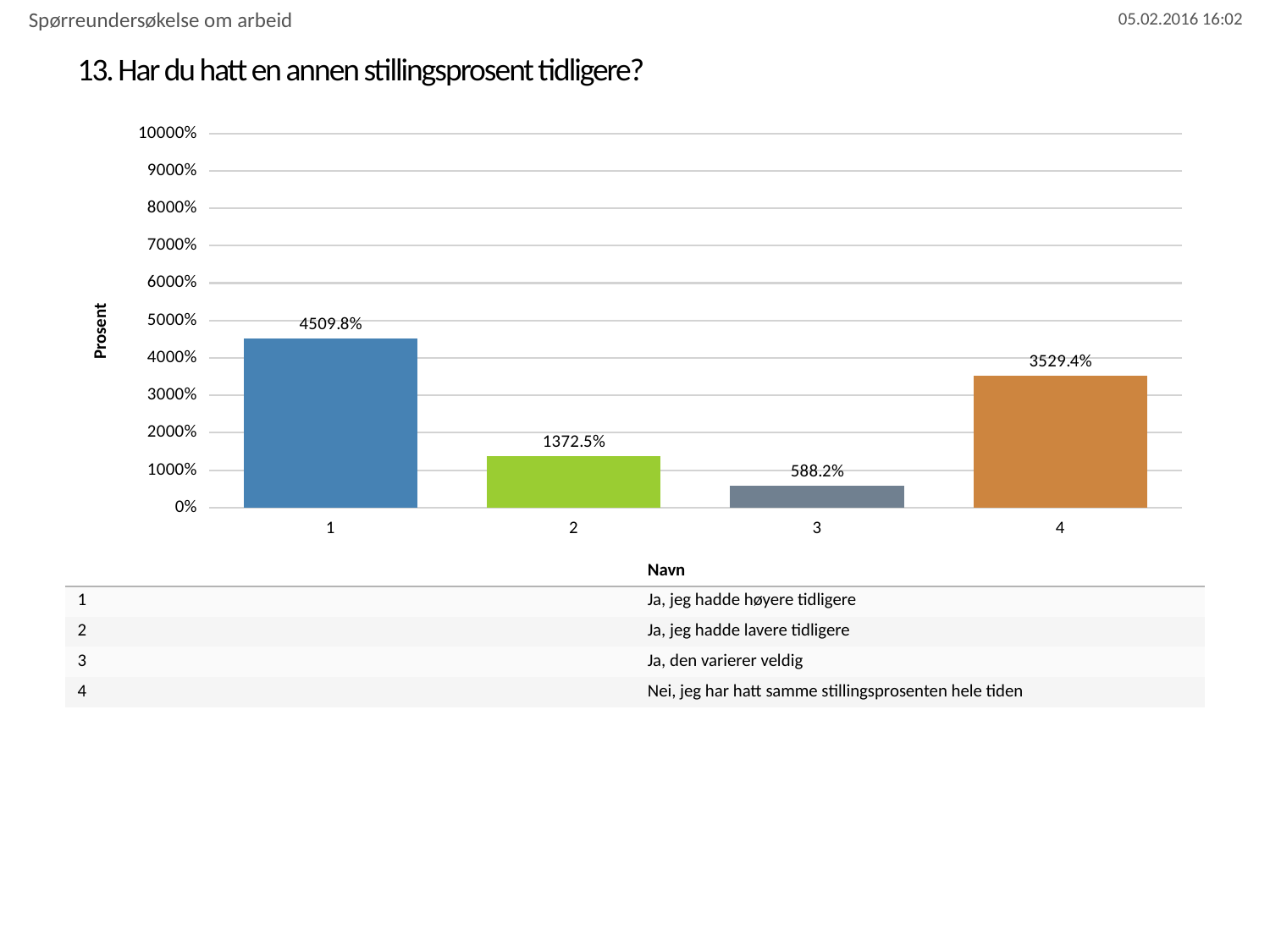
Which category has the lowest value? 3 Which is larger, the value for category 2 or the value for category 4? 4 What is the value for category 1? 4509.8% Which category has the highest value? 1 What kind of chart is shown on the slide? bar chart What is the difference between the values for category 2 and category 3? 784.3% What is the value for category 2? 1372.5% What is the value for category 4? 3529.4% What is the label of the y axis? Prosent What is the difference between the values for category 1 and category 4? 980.4% How many categories are shown in the chart? 4 What is the value for category 3? 588.2%